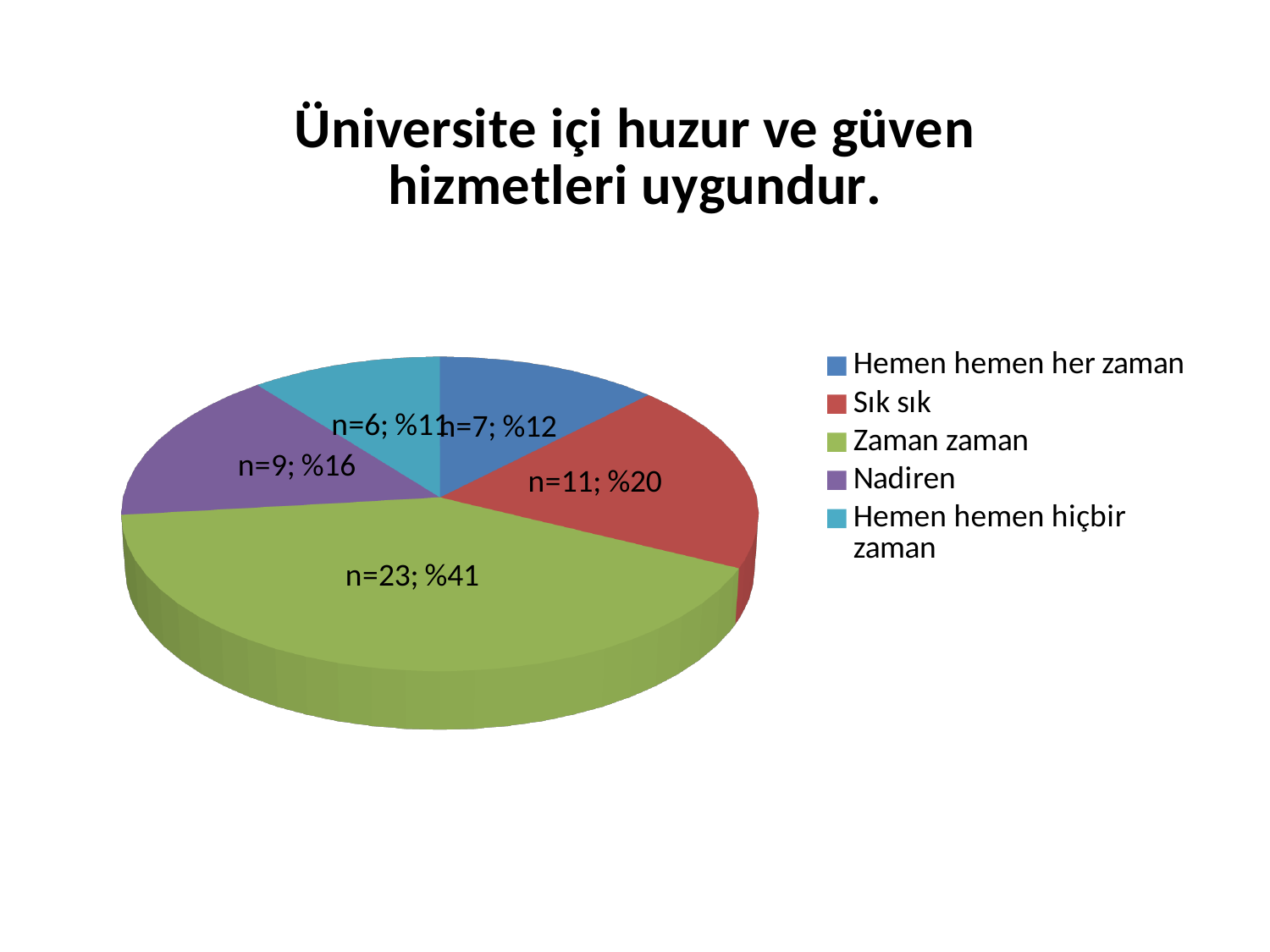
What is the count (n) for the "Zaman zaman" slice? n=23 Which slice is larger, "Nadiren" or "Sık sık"? Sık sık Which category has the smallest slice? Hemen hemen hiçbir zaman What is the title of the chart? Üniversite içi huzur ve güven hizmetleri uygundur. What is the count (n) for the "Hemen hemen hiçbir zaman" slice? n=6 What percentage share does the "Sık sık" slice have? %20 What is the difference in count (n) between "Zaman zaman" and "Sık sık"? 12 What kind of chart is shown on the slide? pie chart Which category has the largest slice? Zaman zaman What is the count (n) for the "Nadiren" slice? n=9 How many categories does the legend list? 5 What percentage share does the "Hemen hemen her zaman" slice have? %12